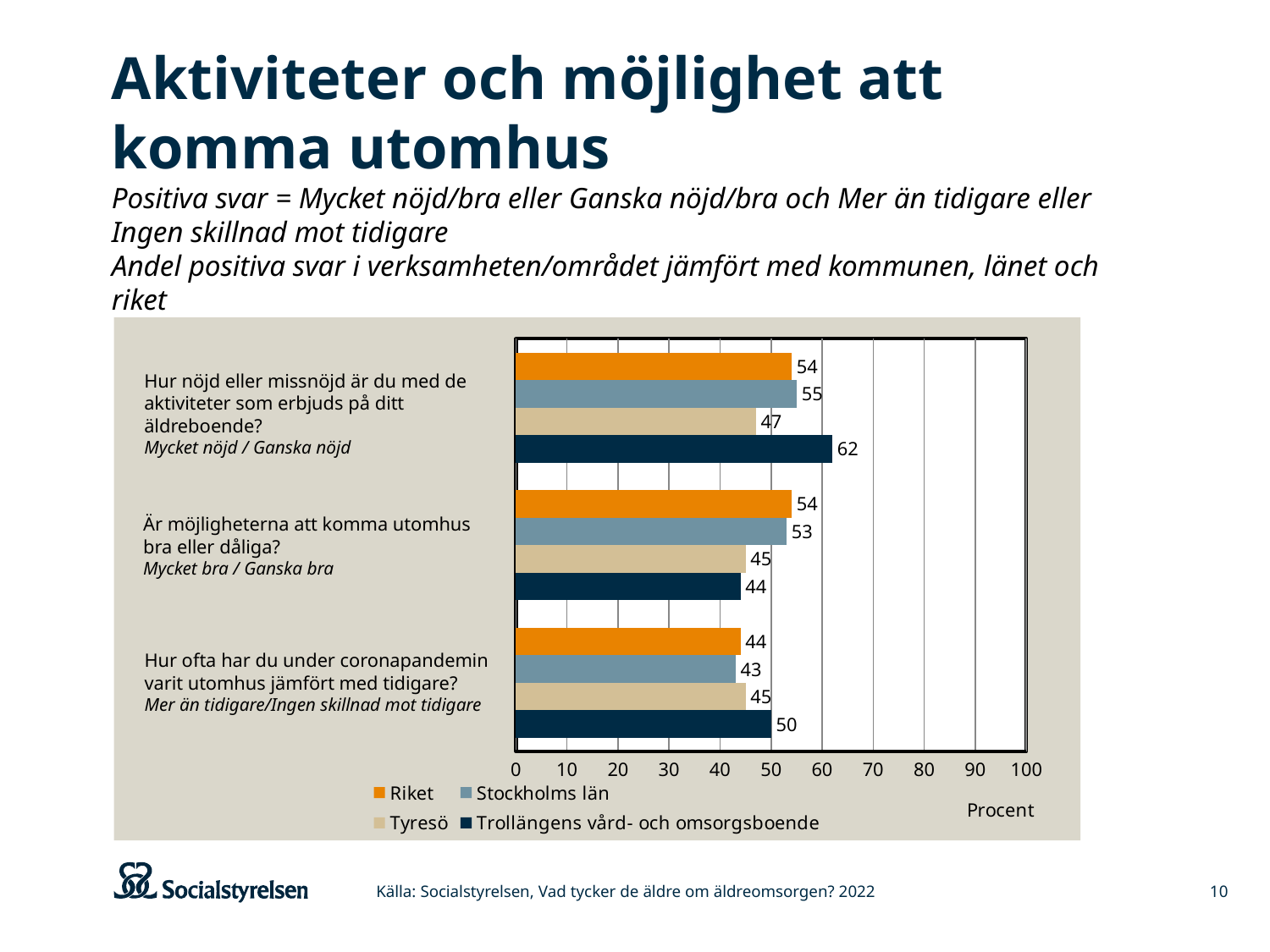
Is the value for Riket for the question 'Är möjligheterna att komma utomhus bra eller dåliga?' greater or less than 50? greater Which series has the lowest value for the question 'Är möjligheterna att komma utomhus bra eller dåliga?'? Trollängens vård- och omsorgsboende For the question 'Hur ofta har du under coronapandemin varit utomhus jämfört med tidigare?', which is larger: the value for Riket or the value for Trollängens vård- och omsorgsboende? Trollängens vård- och omsorgsboende What type of chart is shown on the slide? bar chart How many question categories are shown on the y axis of the chart? 3 How many series does the legend list? 4 What is the difference between the Trollängens vård- och omsorgsboende value and the Tyresö value for the question 'Hur nöjd eller missnöjd är du med de aktiviteter som erbjuds på ditt äldreboende?'? 15 What label is shown on the x axis of the chart? Procent What is the value for Tyresö for the question 'Är möjligheterna att komma utomhus bra eller dåliga?'? 45 Which series has the highest value for the question 'Hur nöjd eller missnöjd är du med de aktiviteter som erbjuds på ditt äldreboende?'? Trollängens vård- och omsorgsboende What is the value for Stockholms län for the question 'Hur ofta har du under coronapandemin varit utomhus jämfört med tidigare?'? 43 What is the value for Trollängens vård- och omsorgsboende for the question 'Hur nöjd eller missnöjd är du med de aktiviteter som erbjuds på ditt äldreboende?'? 62